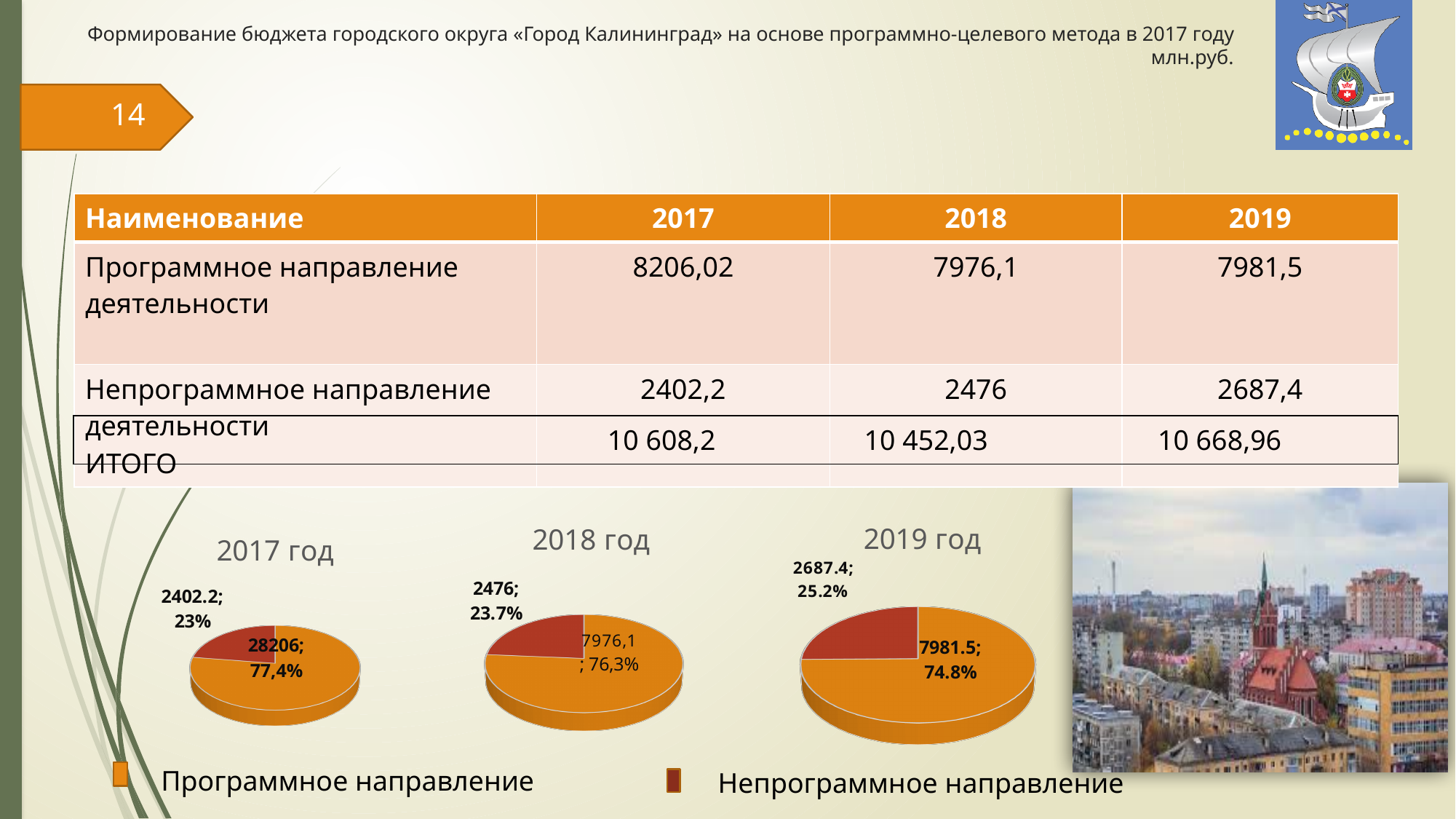
In the "2018 год" pie chart, which category has the smallest slice? Непрограммное направление In the "2017 год" pie chart, what share does Непрограммное направление have? 23% In the "2017 год" pie chart, what share does Программное направление have? 77,4% In the "2019 год" pie chart, which slice is larger, Программное направление or Непрограммное направление? Программное направление In the "2019 год" pie chart, what is the value for Непрограммное направление? 2687.4 How many entries does the shared legend below the pie charts list? 2 What kind of chart is the "2017 год" chart? pie chart In the pie charts, which colour represents Непрограммное направление? red In the "2018 год" pie chart, what share does Непрограммное направление have? 23.7% In the "2018 год" pie chart, what is the value for Программное направление? 7976,1 How many slices does the "2019 год" pie chart have? 2